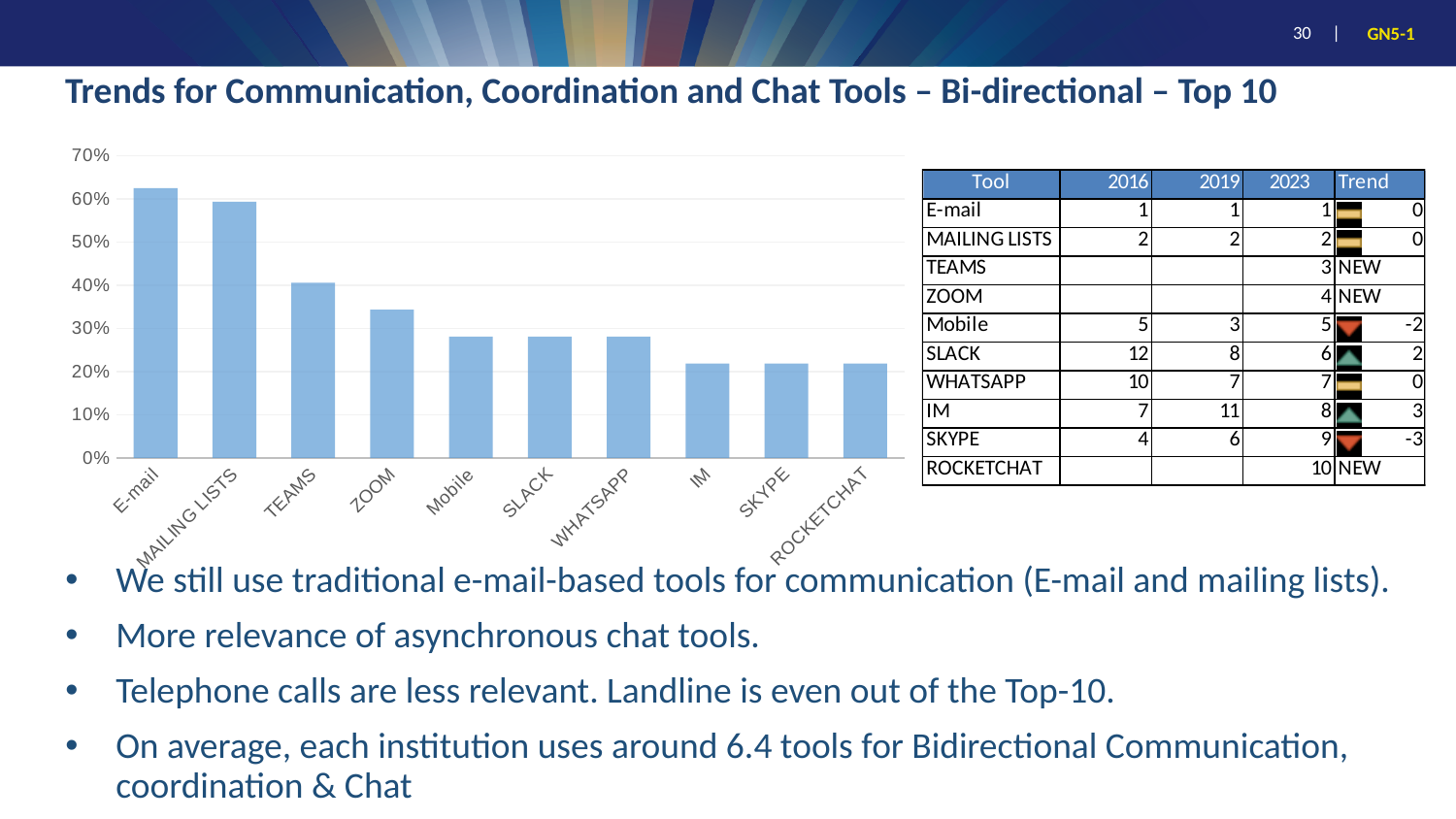
Is the value for ZOOM greater or less than 30%? greater Is the value for SKYPE greater or less than 30%? less Is the value for E-mail greater or less than 60%? greater What kind of chart is shown on the slide? bar chart Which has a larger value, SLACK or ROCKETCHAT? SLACK How many tools (categories) are plotted in the bar chart? 10 Which tool has the highest value in the bar chart? E-mail What is the title of the slide containing the chart? Trends for Communication, Coordination and Chat Tools – Bi-directional – Top 10 Which has a larger value, TEAMS or ZOOM? TEAMS Do the bar values rise or fall from left to right along the x axis? fall